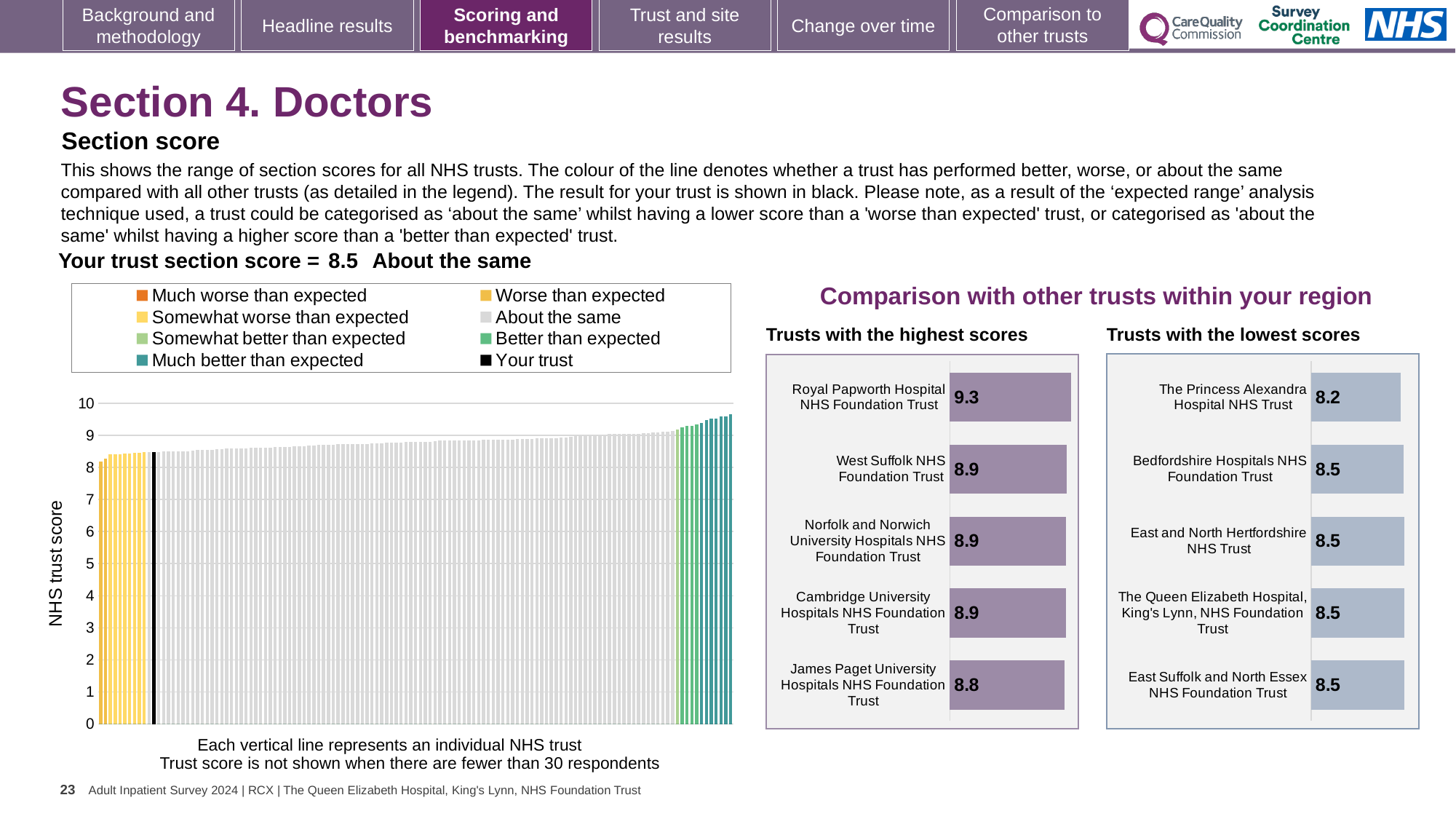
In the 'Trusts with the highest scores' chart, what is the score for James Paget University Hospitals NHS Foundation Trust? 8.8 In the main chart on the left, is the value for the black 'Your trust' bar greater or less than 8? greater In the 'Trusts with the highest scores' chart, what is the difference between the scores of Royal Papworth Hospital NHS Foundation Trust and James Paget University Hospitals NHS Foundation Trust? 0.5 How many trusts are listed in the 'Trusts with the lowest scores' chart? 5 How many entries does the legend of the main chart on the left list? 8 What is the section score for your trust shown on the slide? 8.5 In the 'Trusts with the lowest scores' chart, which trust has the lowest score? The Princess Alexandra Hospital NHS Trust In the 'Trusts with the lowest scores' chart, what is the score for The Princess Alexandra Hospital NHS Trust? 8.2 In the 'Trusts with the highest scores' chart, which trust has the highest score? Royal Papworth Hospital NHS Foundation Trust In the 'Trusts with the highest scores' chart, which has the larger score: Royal Papworth Hospital NHS Foundation Trust or West Suffolk NHS Foundation Trust? Royal Papworth Hospital NHS Foundation Trust In the 'Trusts with the highest scores' chart, what is the score for Royal Papworth Hospital NHS Foundation Trust? 9.3 In the main chart on the left, do the trust scores rise or fall from left to right along the x axis? rise